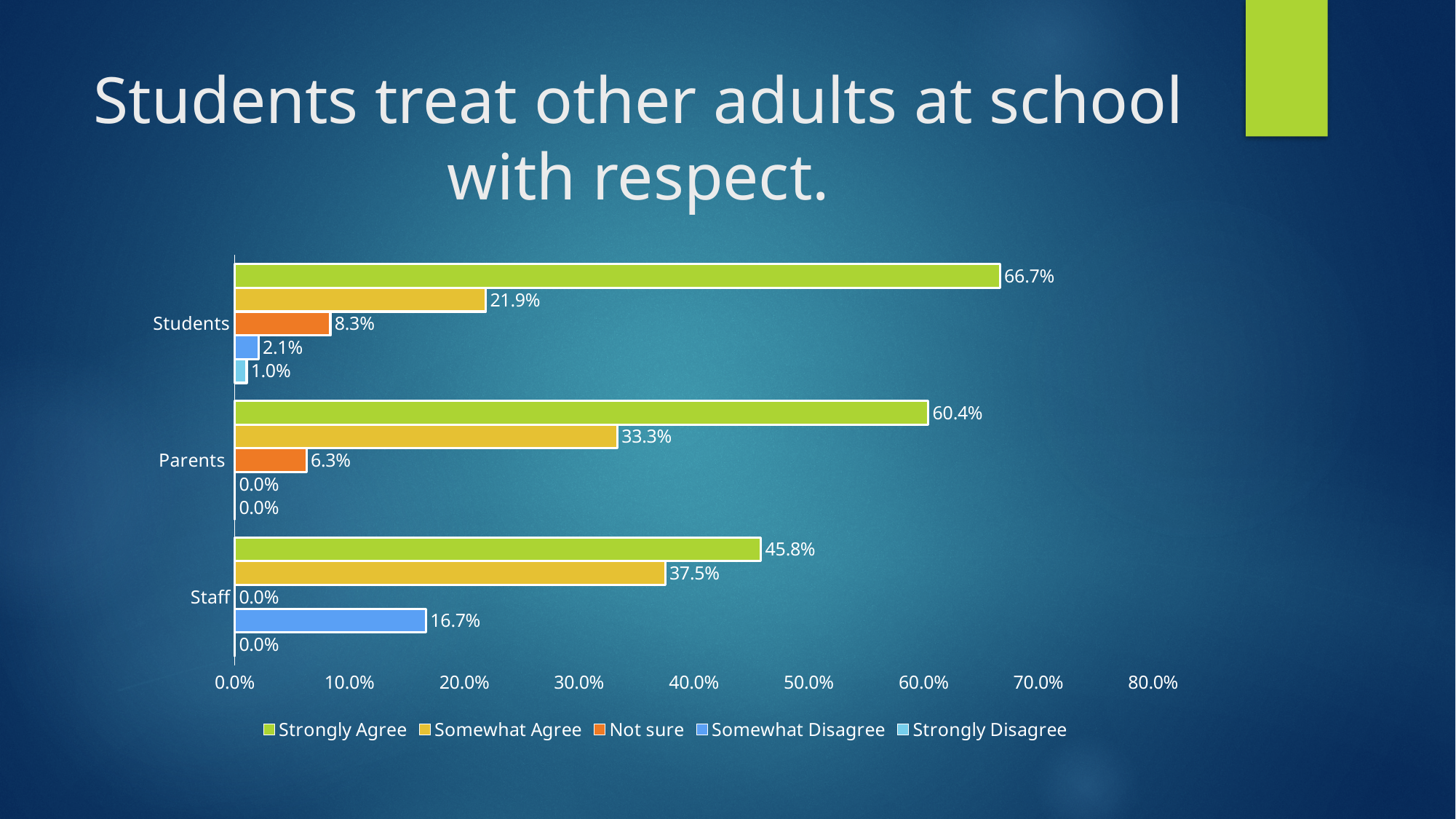
How many respondent groups are shown on the chart? 3 How many series does the legend list? 5 What is the difference between the Strongly Agree percentages for Students and Parents? 6.3% What percentage of Staff responded Somewhat Disagree? 16.7% What is the title of the slide? Students treat other adults at school with respect. What percentage of Students responded Strongly Agree? 66.7% Which is larger: the Somewhat Agree percentage for Staff or for Parents? Staff Which group has the highest Strongly Agree percentage? Students What percentage of Students responded Not sure? 8.3% What kind of chart is shown on the slide? Bar chart Which group has the lowest Strongly Agree percentage? Staff What percentage of Parents responded Somewhat Agree? 33.3%